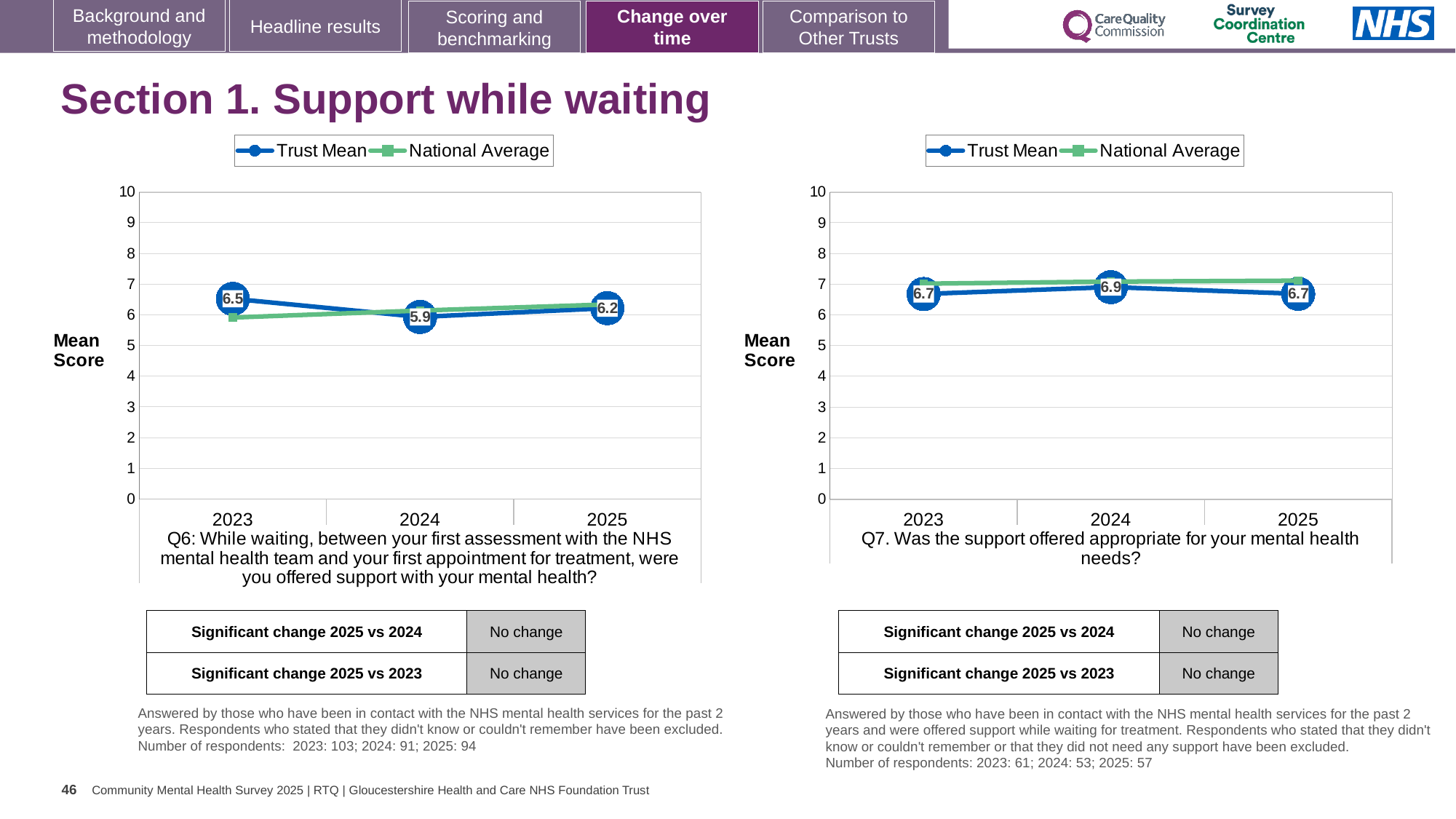
How many series does the legend of the left chart (Q6) list? 2 On the left chart (Q6), what is the Trust Mean score for 2024? 5.9 On the right chart (Q7), which year has the highest Trust Mean score? 2024 On the left chart (Q6), which year has the highest Trust Mean score? 2023 On the left chart (Q6), what is the Trust Mean score for 2023? 6.5 On the left chart (Q6), what is the Trust Mean score for 2025? 6.2 On the right chart (Q7), is the National Average for 2025 greater or less than 6? greater On the left chart (Q6), what is the difference between the Trust Mean scores for 2023 and 2024? 0.6 On the left chart (Q6), which year has the lowest Trust Mean score? 2024 What type of chart is the right chart (Q7)? Line chart On the right chart (Q7), what is the Trust Mean score for 2024? 6.9 On the right chart (Q7), what is the Trust Mean score for 2025? 6.7